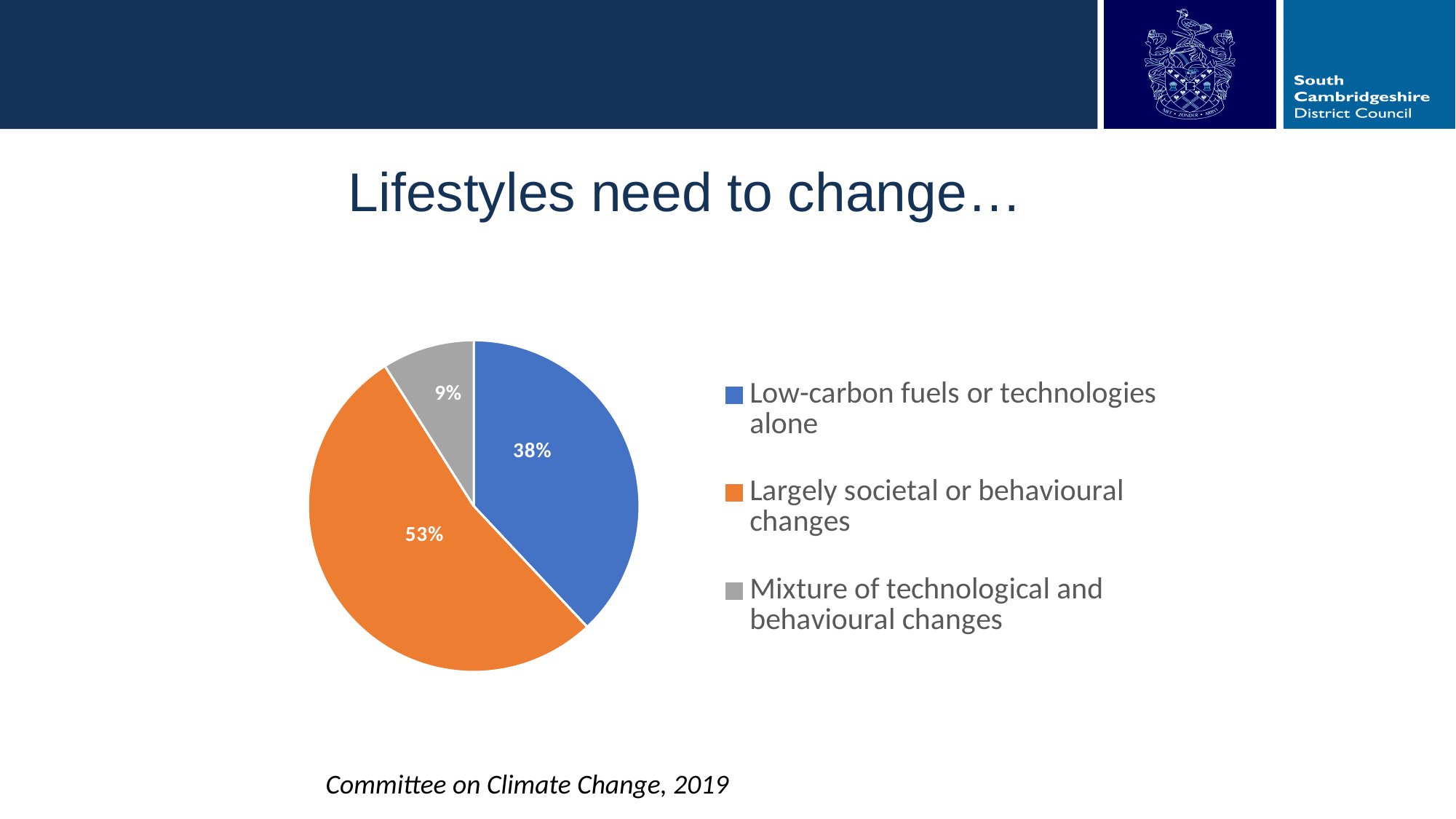
What share of the pie is labelled for 'Largely societal or behavioural changes'? 53% How many entries does the legend list? 3 Which category has the smallest slice of the pie? Mixture of technological and behavioural changes What is the difference in percentage points between the 'Largely societal or behavioural changes' slice and the 'Low-carbon fuels or technologies alone' slice? 15 percentage points What source is cited below the chart? Committee on Climate Change, 2019 Which is larger: the slice for 'Low-carbon fuels or technologies alone' or the slice for 'Mixture of technological and behavioural changes'? Low-carbon fuels or technologies alone What share of the pie is labelled for 'Mixture of technological and behavioural changes'? 9% What colour is the slice for 'Largely societal or behavioural changes'? Orange What share of the pie is labelled for 'Low-carbon fuels or technologies alone'? 38% How many slices does the pie chart have? 3 What kind of chart is shown on the slide? Pie chart Which category has the largest slice of the pie? Largely societal or behavioural changes